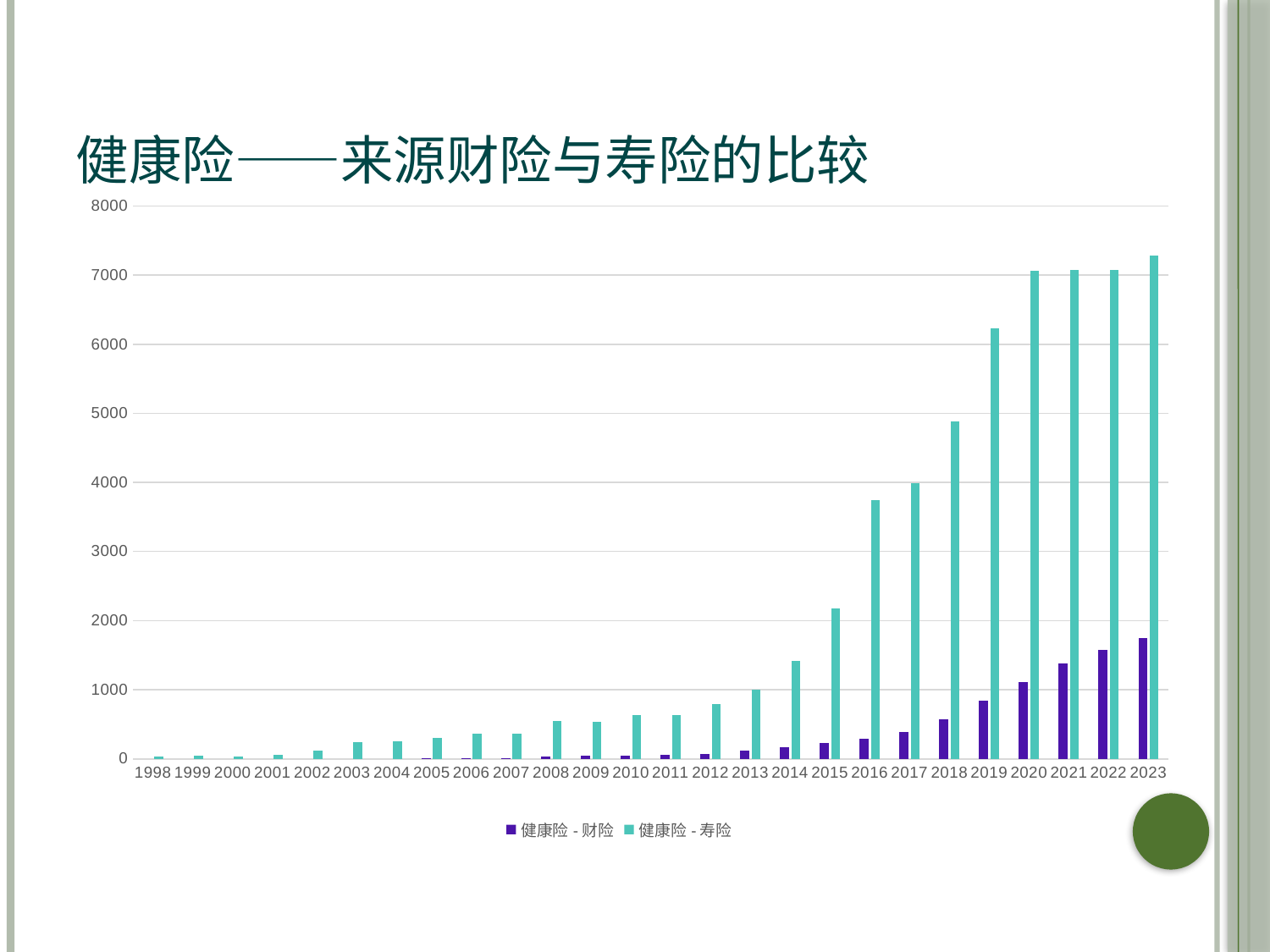
What is the title of the slide? 健康险——来源财险与寿险的比较 Do the values for 健康险 - 寿险 generally rise or fall from 1998 to 2023? rise How many years are shown along the x axis? 26 Is the value for 健康险 - 财险 in 2023 greater or less than 1000? greater Is the value for 健康险 - 寿险 in 2018 greater or less than 5000? less Is the value for 健康险 - 寿险 in 2016 greater or less than 3000? greater What kind of chart is shown on the slide? bar chart Which year has the highest value for 健康险 - 寿险? 2023 Which year has the highest value for 健康险 - 财险? 2023 In 2020, which series has the larger value, 健康险 - 财险 or 健康险 - 寿险? 健康险 - 寿险 How many series does the legend list? 2